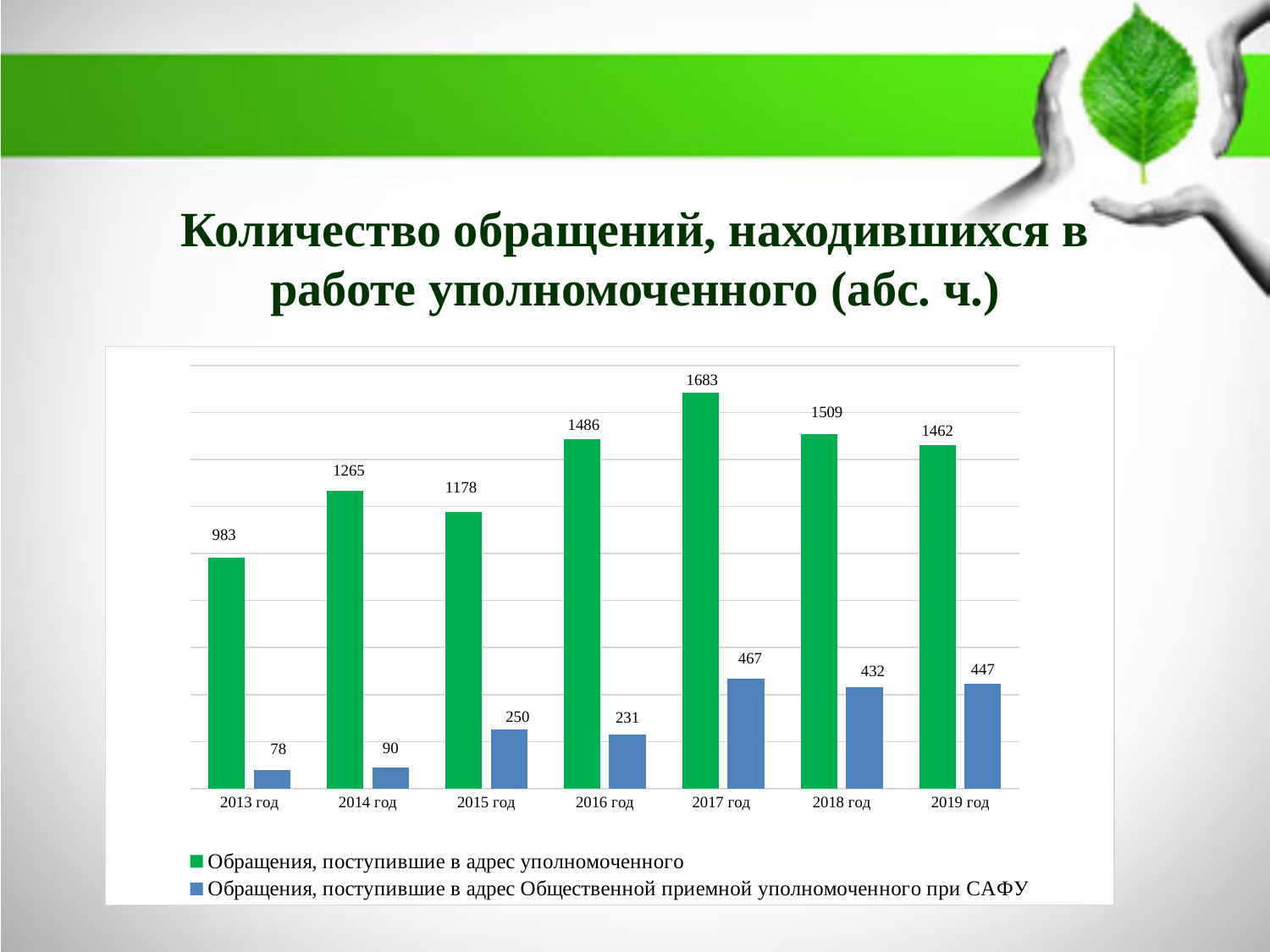
Which year has the lowest value for 'Обращения, поступившие в адрес Общественной приемной уполномоченного при САФУ'? 2013 год What is the difference between the 2017 год and 2018 год values for 'Обращения, поступившие в адрес уполномоченного'? 174 How many series does the legend list? 2 What is the value for 2015 год in the series 'Обращения, поступившие в адрес Общественной приемной уполномоченного при САФУ'? 250 What is the difference between the 2013 год and 2014 год values for 'Обращения, поступившие в адрес Общественной приемной уполномоченного при САФУ'? 12 What colour are the bars for 'Обращения, поступившие в адрес уполномоченного'? Green Do the values for 'Обращения, поступившие в адрес уполномоченного' rise or fall from 2013 год to 2017 год? Rise What kind of chart is shown on the slide? Bar chart What is the value for 2017 год in the series 'Обращения, поступившие в адрес уполномоченного'? 1683 Which is larger for 'Обращения, поступившие в адрес Общественной приемной уполномоченного при САФУ': 2018 год or 2019 год? 2019 год Which year has the highest value for 'Обращения, поступившие в адрес уполномоченного'? 2017 год How many years are shown on the x axis? 7